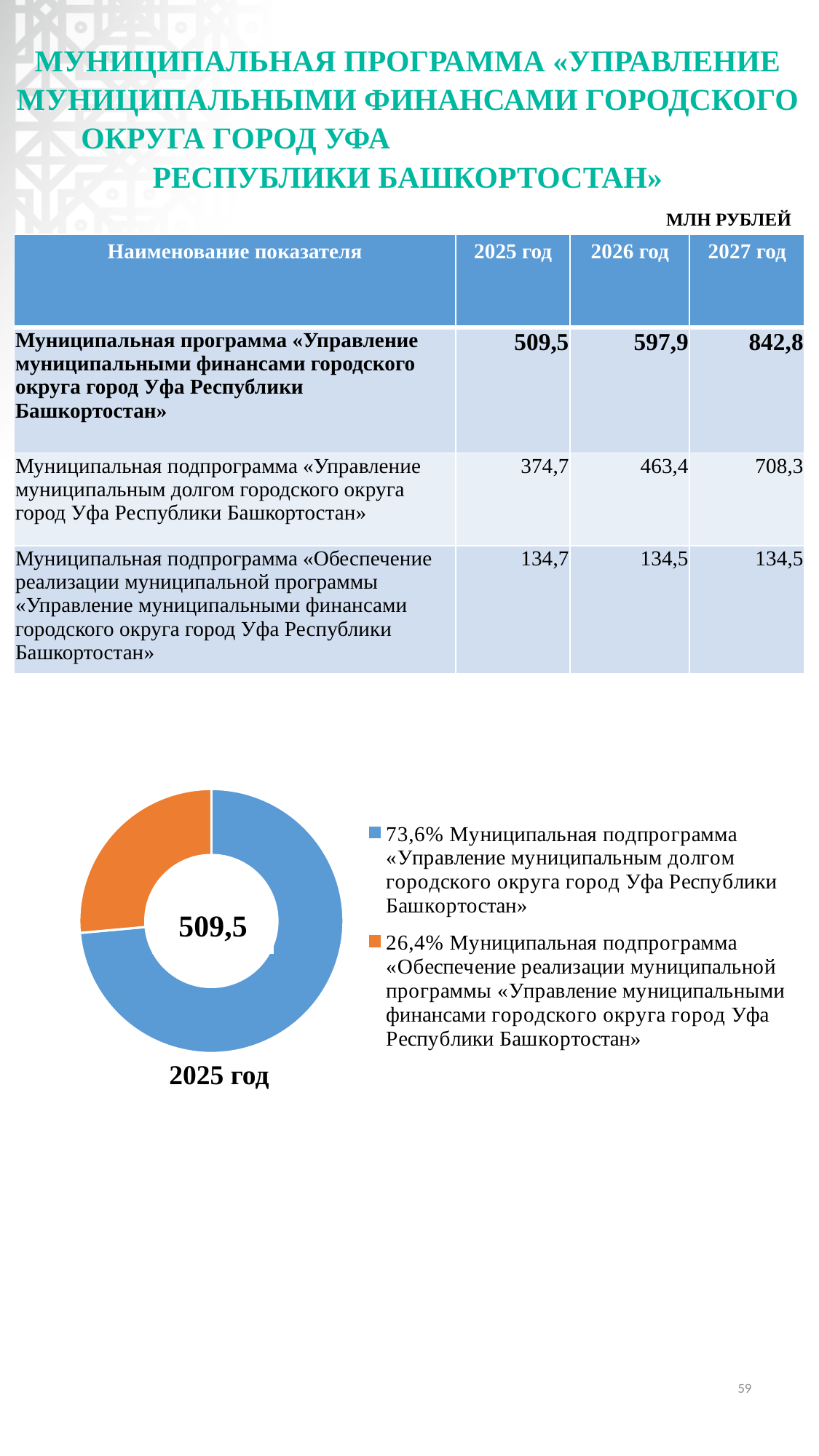
What value is printed in the centre of the doughnut chart? 509,5 By how many percentage points does the 73,6% slice exceed the 26,4% slice in the pie chart? 47,2 percentage points What kind of chart is shown at the bottom of the slide? Pie chart (doughnut) Which slice of the pie chart is the smallest? Муниципальная подпрограмма «Обеспечение реализации муниципальной программы «Управление муниципальными финансами городского округа город Уфа Республики Башкортостан»» Is the share of the orange slice in the pie chart greater or less than 50%? less How many slices does the pie chart have? 2 What share of the pie chart does the subprogram «Обеспечение реализации муниципальной программы «Управление муниципальными финансами городского округа город Уфа Республики Башкортостан»» take? 26,4% How many entries does the legend of the pie chart list? 2 Which slice of the pie chart is the largest? Муниципальная подпрограмма «Управление муниципальным долгом городского округа город Уфа Республики Башкортостан» Which year does the pie chart represent, according to its title? 2025 год What share of the pie chart does the subprogram «Управление муниципальным долгом городского округа город Уфа Республики Башкортостан» take? 73,6% In the pie chart, which is larger: the share of the debt management subprogram or the share of the implementation support subprogram? The debt management subprogram (73,6%)